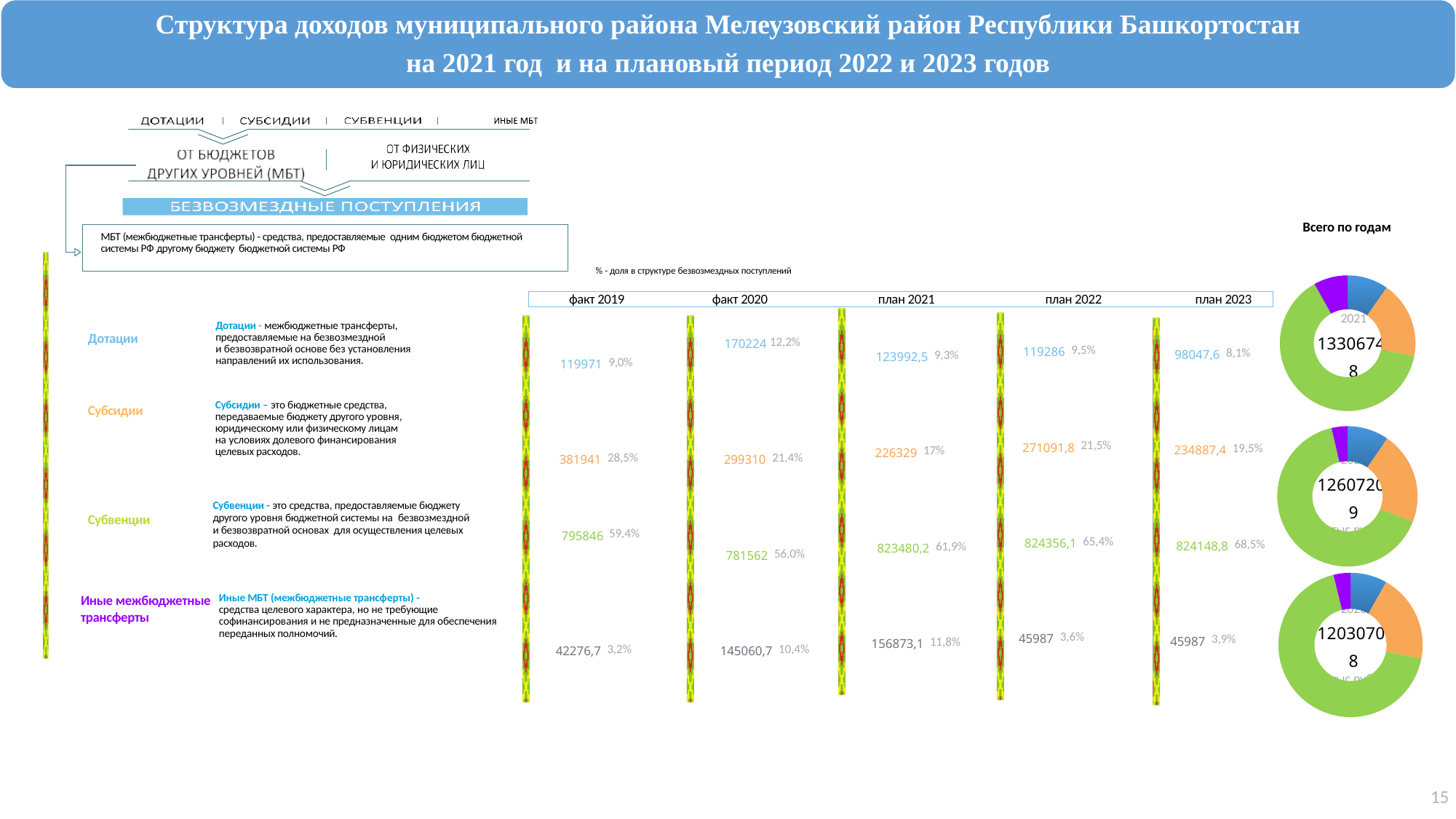
In the table of безвозмездные поступления, what is the difference between the Иные межбюджетные трансферты values for план 2021 and план 2022? 110886,1 In the table of безвозмездные поступления, what is the value of Дотации for факт 2019? 119971 In the table of безвозмездные поступления, how many periods (columns) are shown? 5 Which colour takes up the largest share in each of the donut charts under "Всего по годам"? green How many slices does each of the donut charts under "Всего по годам" have? 4 What total value is printed in the centre of the top donut chart (2021) under "Всего по годам"? 1330674,8 In the table of безвозмездные поступления, is the value of Субсидии larger for факт 2019 or факт 2020? факт 2019 In the table of безвозмездные поступления, which category has the highest share in план 2023? Субвенции In the table of безвозмездные поступления, which category has the lowest share in план 2022? Иные межбюджетные трансферты In the table of безвозмездные поступления, what share do Субвенции have in план 2022? 65,4% What total value is printed in the centre of the bottom donut chart under "Всего по годам"? 1203070,8 What kind of charts are shown under the heading "Всего по годам" on the right of the slide? pie (donut) charts